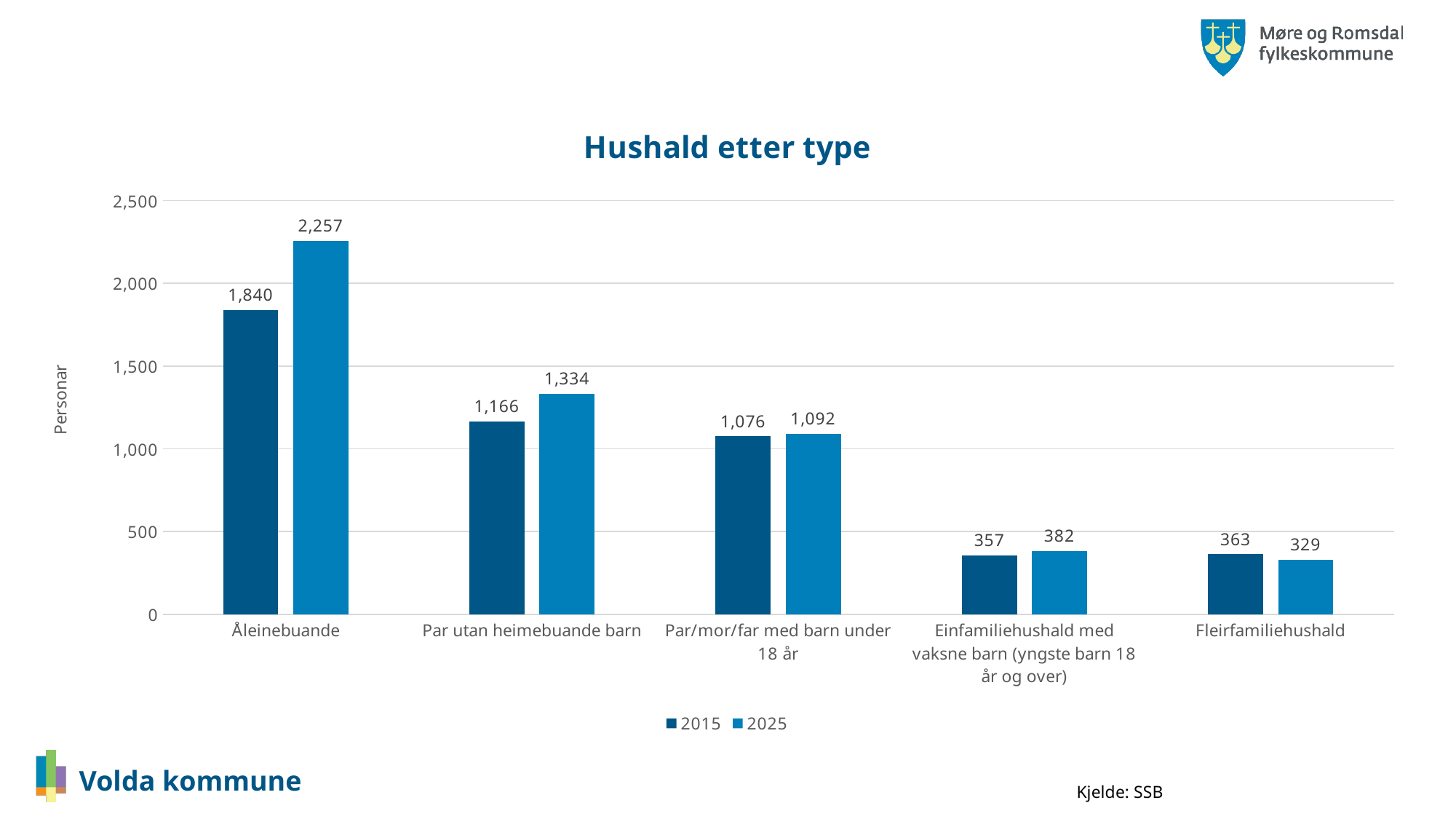
Is the 2015 value for Par/mor/far med barn under 18 år greater or less than 1,000? greater What kind of chart is shown on the slide? Bar chart What is the difference between the 2025 and 2015 values for Åleinebuande? 417 Which category has the highest value in 2015? Åleinebuande What is the value for Åleinebuande in 2025? 2,257 Which is larger for Fleirfamiliehushald, the 2015 value or the 2025 value? 2015 What is the value for Par utan heimebuande barn in 2015? 1,166 How many series does the legend list? 2 What is the difference between the 2025 and 2015 values for Par utan heimebuande barn? 168 How many household categories are shown on the x axis? 5 Which category has the lowest value in 2025? Fleirfamiliehushald What is the value for Fleirfamiliehushald in 2025? 329